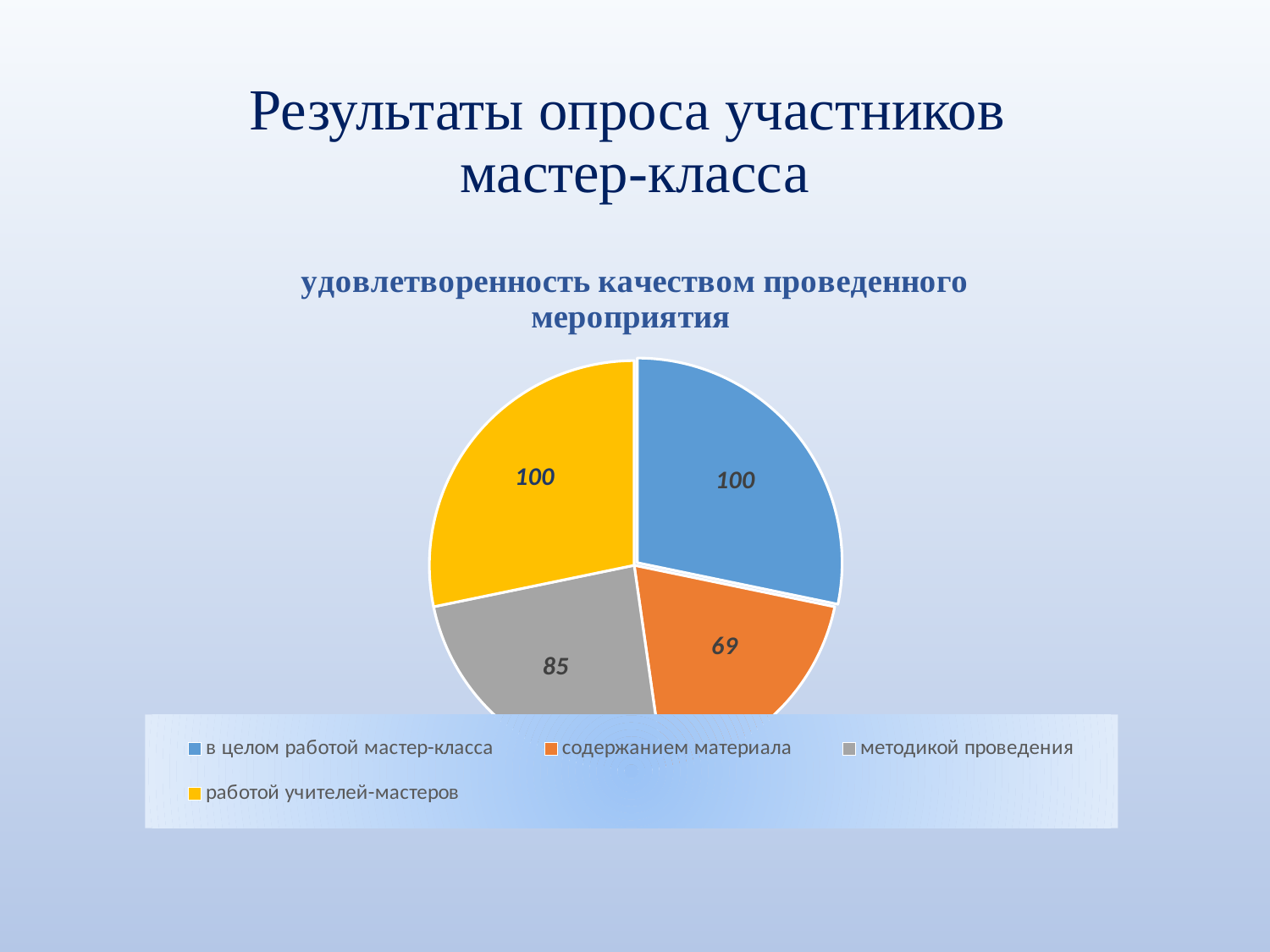
What is the value for "методикой проведения"? 85 Which category has the lowest value? содержанием материала What is the difference between the values for "методикой проведения" and "содержанием материала"? 16 Which colour represents "работой учителей-мастеров" in the chart? yellow What is the value for "работой учителей-мастеров"? 100 Which is larger: the value for "методикой проведения" or for "содержанием материала"? методикой проведения What is the title of the chart? удовлетворенность качеством проведенного мероприятия What is the difference between the values for "в целом работой мастер-класса" and "содержанием материала"? 31 What kind of chart is shown on the slide? pie chart What is the value for "содержанием материала"? 69 What is the value for "в целом работой мастер-класса"? 100 How many slices does the pie chart have? 4